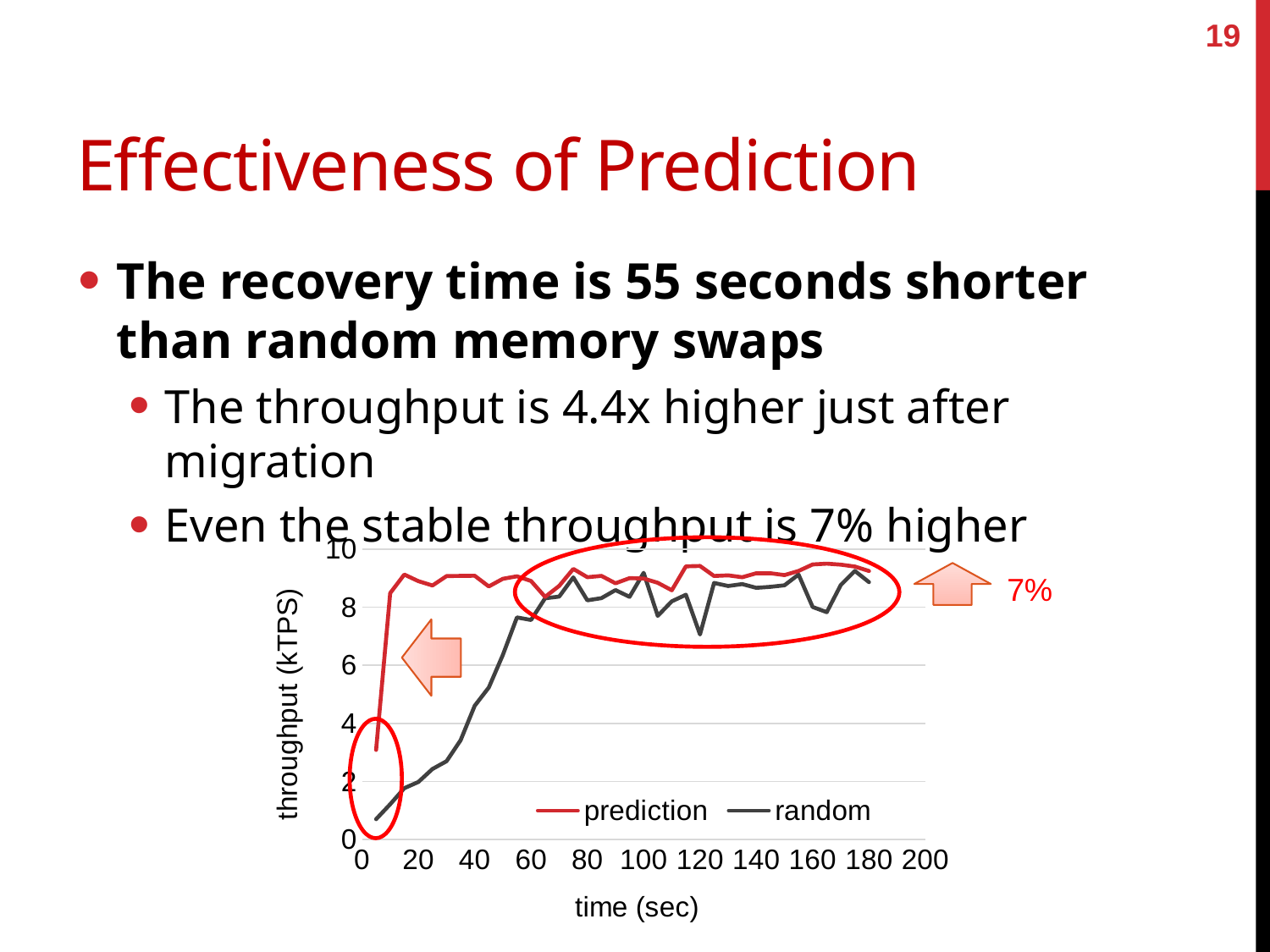
What kind of chart is shown on the slide? line chart What is the label of the y axis of the chart? throughput (kTPS) At time 20 sec, which series has the higher throughput, prediction or random? prediction Is the value of the random series at time 20 sec greater or less than 4? less Is the value of the prediction series at time 20 sec greater or less than 8? greater At time 40 sec, which series has the higher throughput, prediction or random? prediction Which series reaches a throughput above 8 kTPS first, prediction or random? prediction How many series does the chart legend list? 2 Does the random series rise or fall between time 0 and time 60 sec? rise Is the value of the random series at time 40 sec greater or less than 6? less What are the two series named in the chart legend? prediction and random